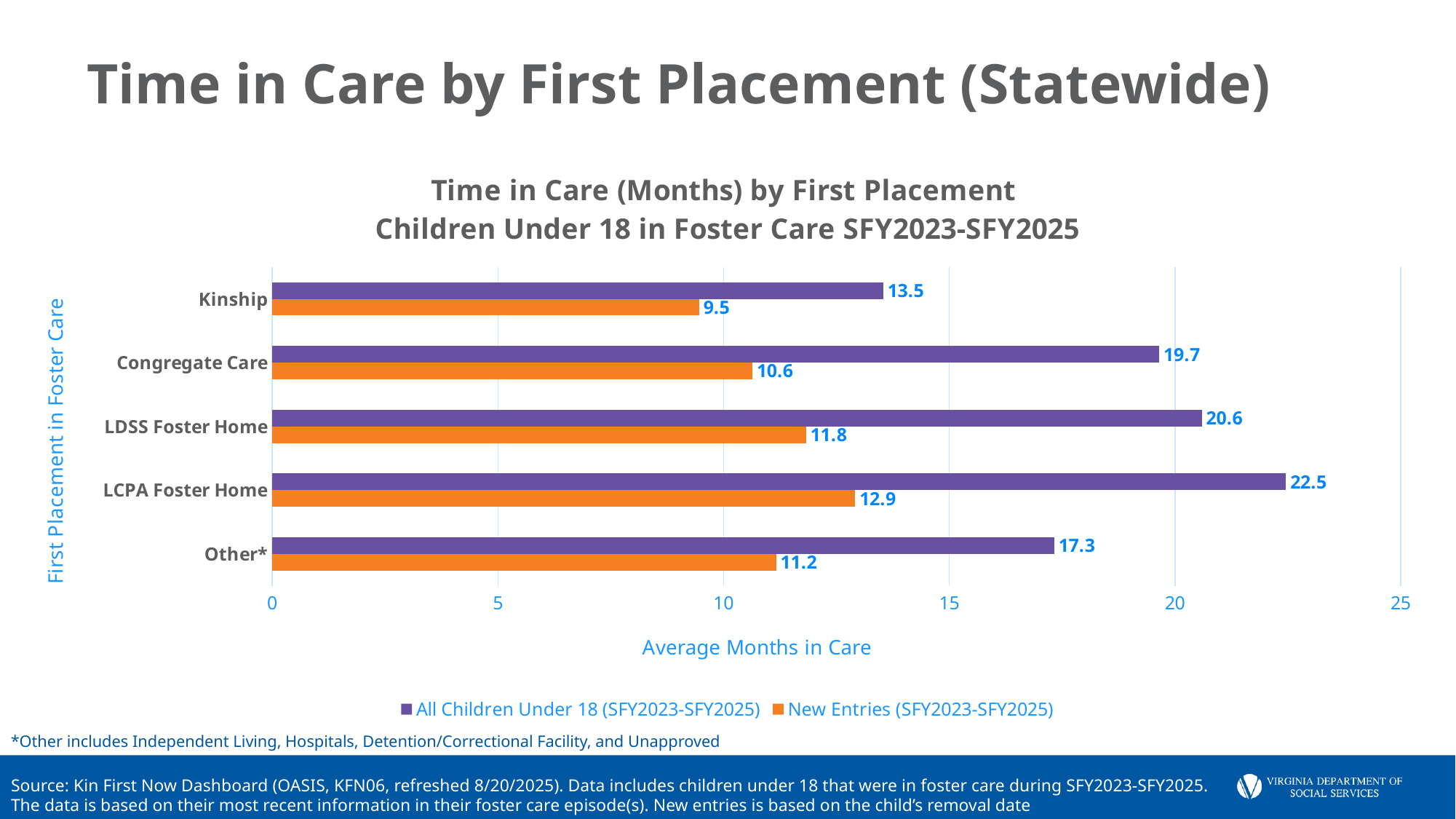
How many series does the legend list? 2 Which first placement has the highest average months in care for All Children Under 18 (SFY2023-SFY2025)? LCPA Foster Home Which first placement has the lowest average months in care for New Entries (SFY2023-SFY2025)? Kinship How many first placement categories are shown on the chart? 5 What is the average months in care for New Entries (SFY2023-SFY2025) with a first placement of LDSS Foster Home? 11.8 What kind of chart is shown on the slide? Bar chart Which colour represents New Entries (SFY2023-SFY2025) in the chart? Orange What is the difference between the All Children Under 18 and New Entries values for Congregate Care? 9.1 Which is larger: the New Entries value for LCPA Foster Home or the New Entries value for Other*? LCPA Foster Home What is the average months in care for Kinship among All Children Under 18 (SFY2023-SFY2025)? 13.5 What is the label of the horizontal axis? Average Months in Care Is the All Children Under 18 value for Other* greater or less than 15? greater